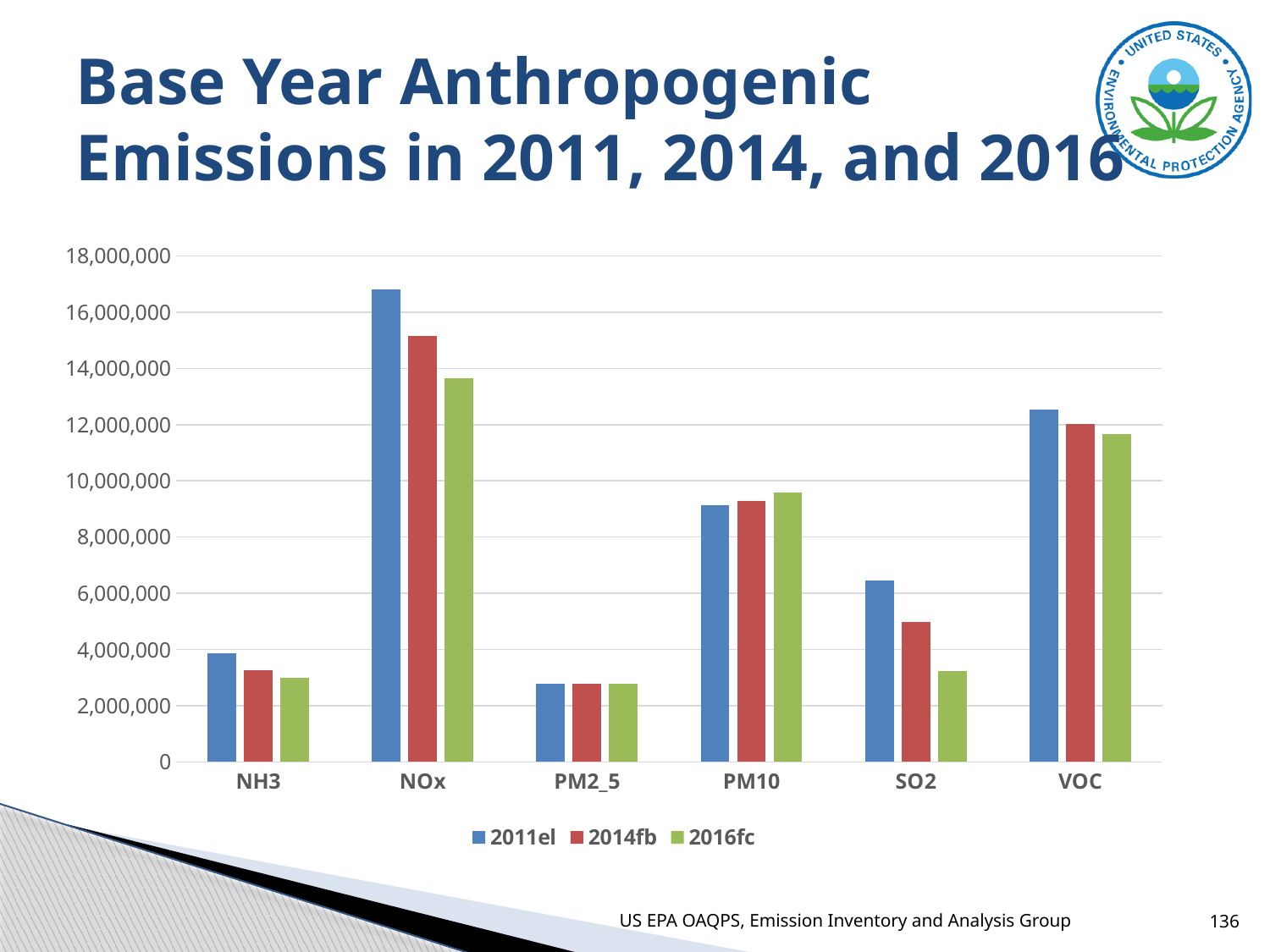
Which pollutant has the highest 2011el emissions? NOx For the 2014fb series, which is larger: NOx or VOC? NOx For SO2, which is larger: the 2011el value or the 2014fb value? 2011el Is the 2011el value for VOC greater or less than 12,000,000? greater Which pollutant has the lowest 2011el emissions? PM2_5 For SO2, do the values rise or fall from 2011el to 2016fc? fall How many pollutant categories are shown on the x axis? 6 What are the three series names listed in the legend? 2011el, 2014fb, 2016fc Is the 2016fc value for SO2 greater or less than 4,000,000? less How many series does the legend list? 3 What kind of chart is shown on the slide? bar chart Is the 2011el value for NOx greater or less than 16,000,000? greater